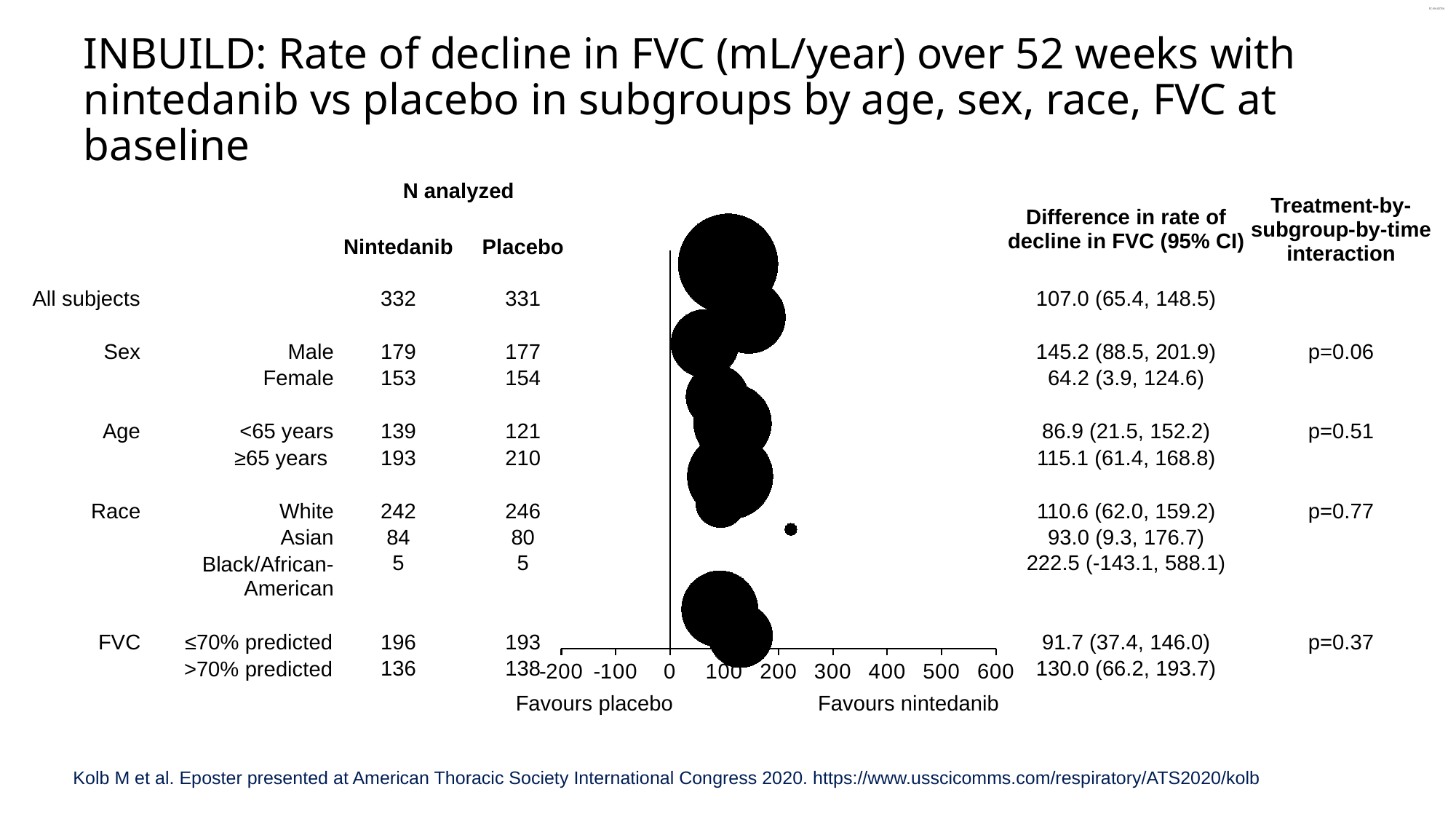
What is the difference in rate of decline in FVC (95% CI) for All subjects? 107.0 (65.4, 148.5) Which age subgroup has the larger point estimate for the difference in rate of decline in FVC, <65 years or ≥65 years? ≥65 years How many rows (All subjects plus subgroups) are plotted in the forest plot? 10 What is the upper limit of the 95% CI for the Black/African-American subgroup? 588.1 Which subgroup has the smallest point estimate for the difference in rate of decline in FVC? Female What label appears under the right side of the x axis? Favours nintedanib What is the point estimate of the difference in rate of decline in FVC for the Male subgroup? 145.2 Which subgroup has the largest point estimate for the difference in rate of decline in FVC? Black/African-American What is the difference between the point estimates for the Male and Female subgroups? 81.0 What kind of chart is shown on the slide? forest plot What is the p-value for the treatment-by-subgroup-by-time interaction for Sex? p=0.06 Is the point estimate for the White subgroup greater or less than 100? greater